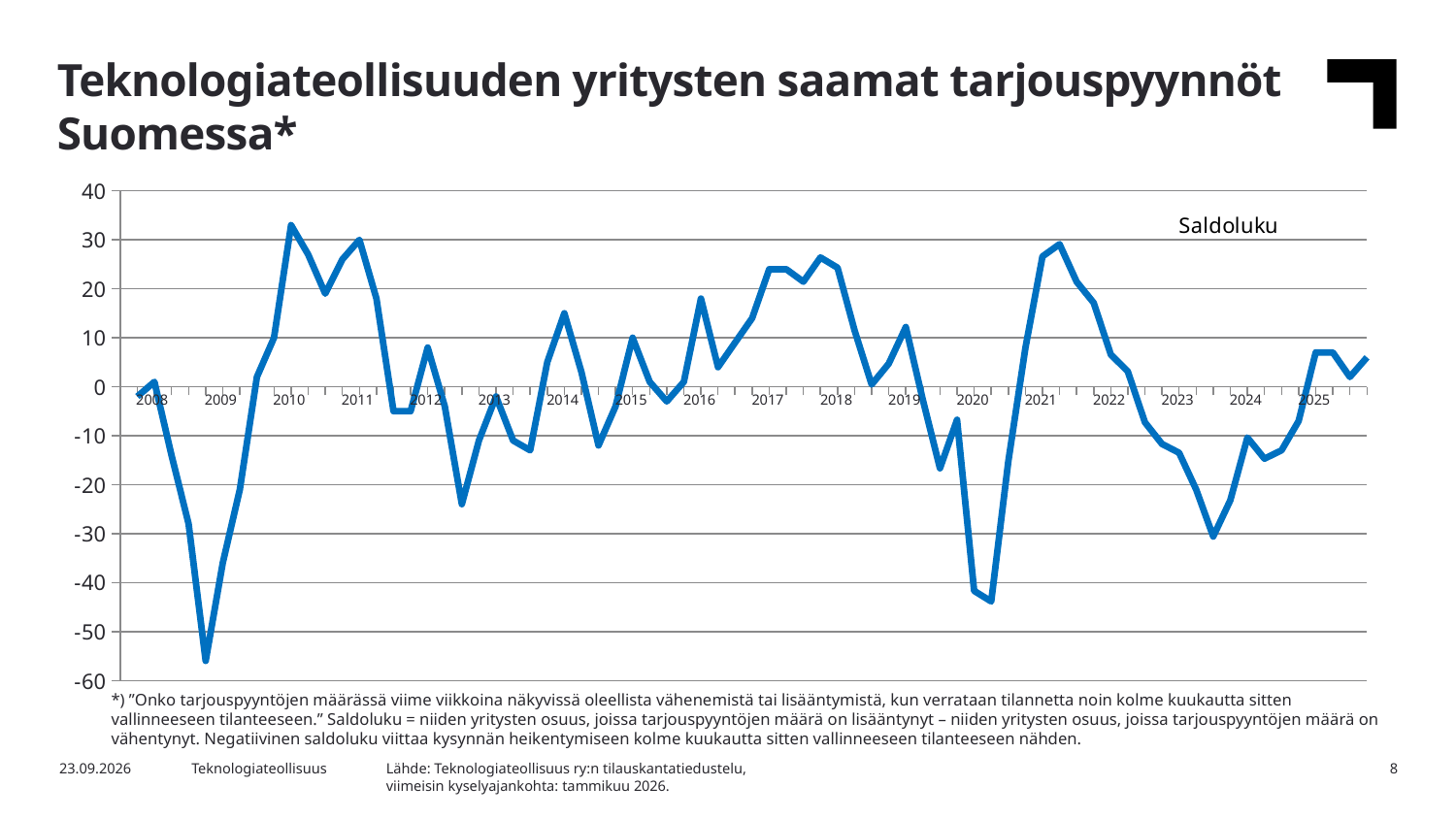
Is the peak value of the line in 2021 greater or less than 20? greater Does the line rise or fall between 2008 and early 2009? fall In which year does the line reach its lowest point? 2009 How many series does the chart plot? 1 Is the lowest value of the line, in 2009, greater or less than -50? less How many year labels are shown on the x axis? 18 What is the name of the series plotted in the chart? Saldoluku What is the highest value shown on the y axis? 40 Is the peak value of the line in 2010 greater or less than 30? greater Which low point is lower: the one in 2009 or the one in 2020? 2009 What kind of chart is shown on the slide? line chart